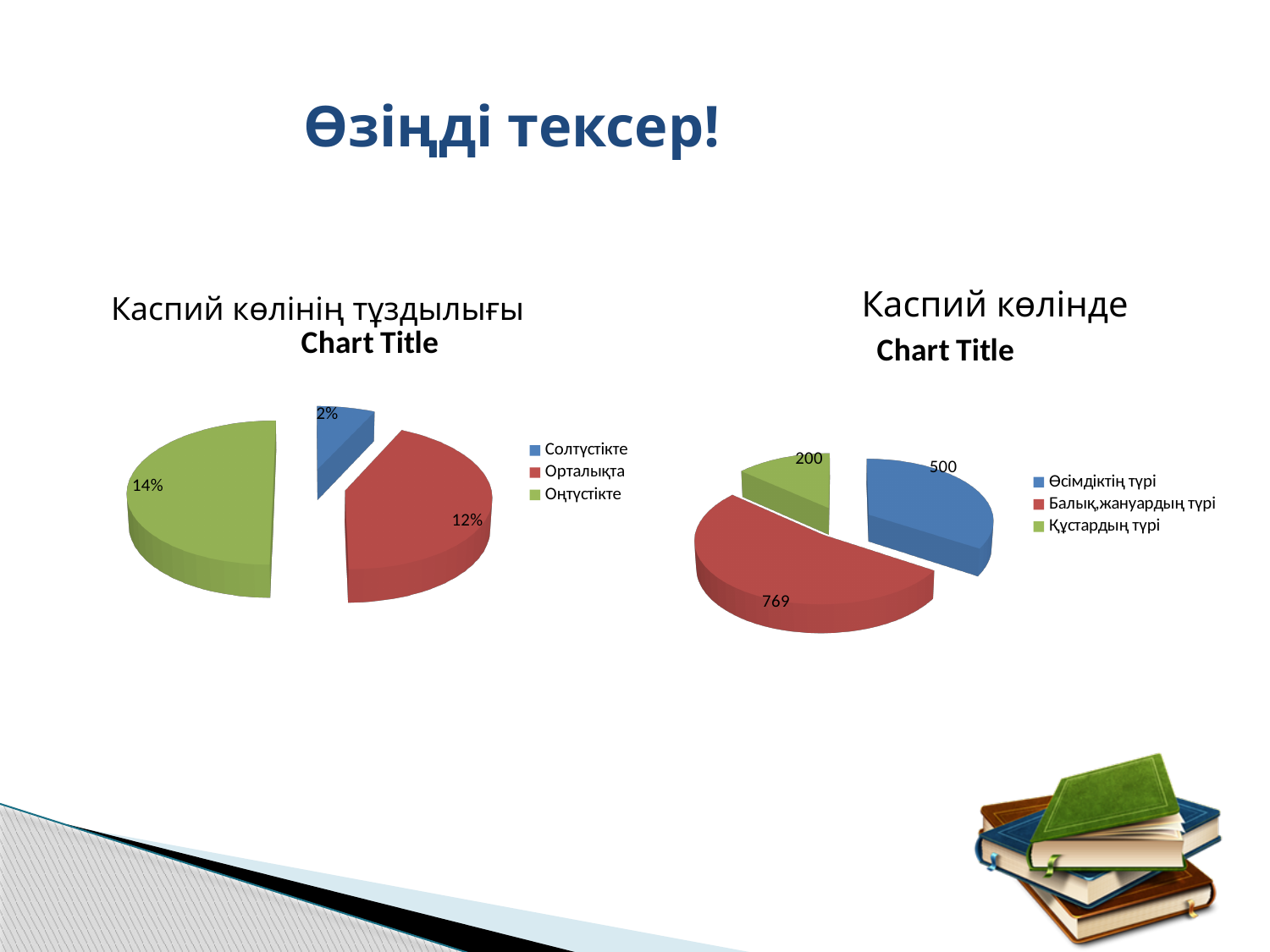
In the left chart (Каспий көлінің тұздылығы), which category has the lowest value? Солтүстікте In the right chart (Каспий көлінде), which category has the largest slice? Балық,жануардың түрі In the right chart (Каспий көлінде), what is the difference between the values for Балық,жануардың түрі and Өсімдіктің түрі? 269 In the right chart (Каспий көлінде), which colour represents Өсімдіктің түрі? blue How many entries does the legend of the left chart (Каспий көлінің тұздылығы) list? 3 What type of chart is the left chart (Каспий көлінің тұздылығы)? pie chart In the left chart (Каспий көлінің тұздылығы), what is the value for Орталықта? 12% In the right chart (Каспий көлінде), what is the value for Балық,жануардың түрі? 769 In the right chart (Каспий көлінде), what is the value for Құстардың түрі? 200 In the left chart (Каспий көлінің тұздылығы), what is the value for Солтүстікте? 2% In the left chart (Каспий көлінің тұздылығы), what is the difference between the values for Оңтүстікте and Солтүстікте? 12% In the left chart (Каспий көлінің тұздылығы), which category has the highest value? Оңтүстікте